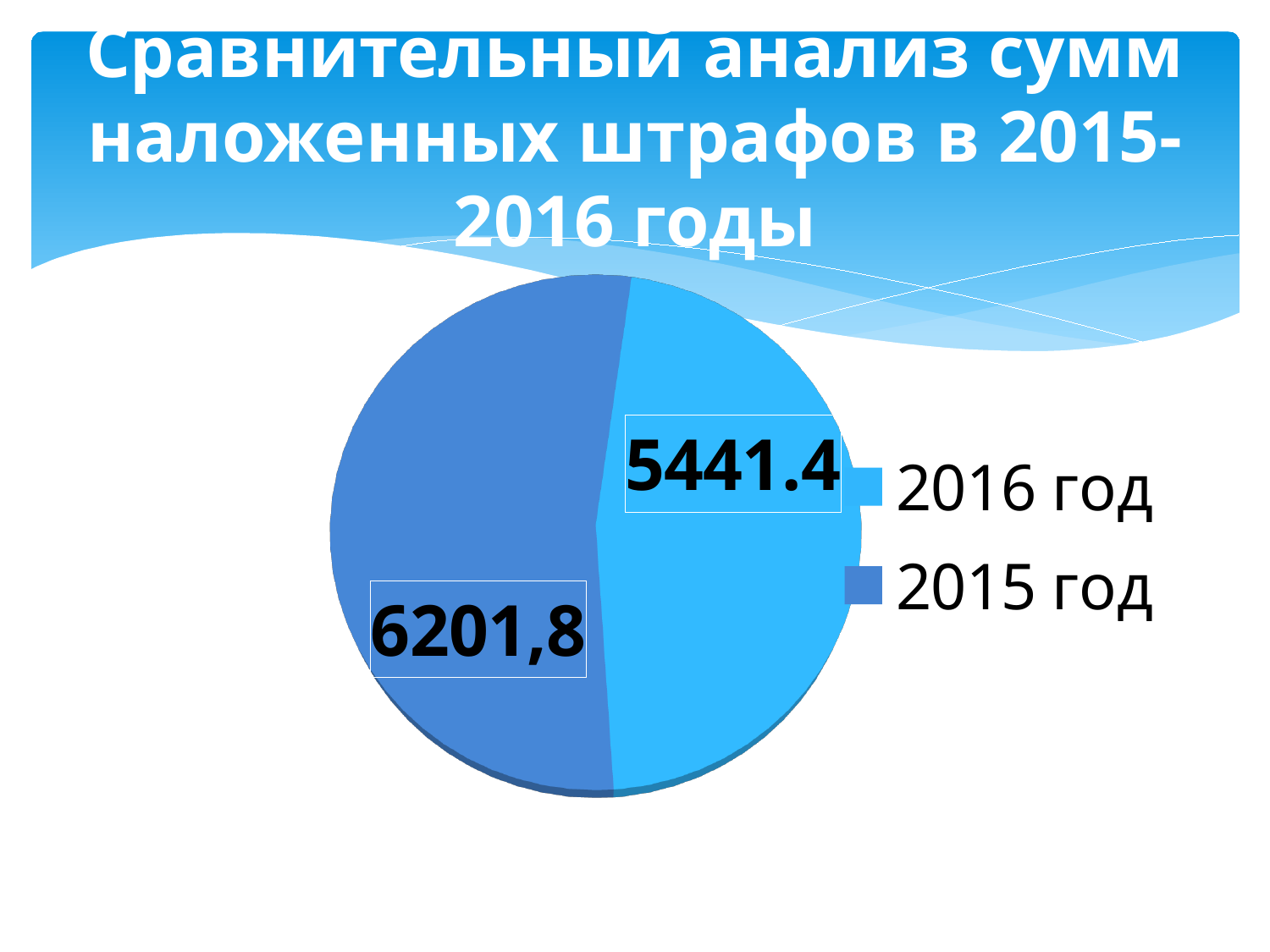
What is the title of the slide? Сравнительный анализ сумм наложенных штрафов в 2015-2016 годы Which year has the smaller slice in the pie chart? 2016 год How many entries does the legend list? 2 How many slices does the pie chart have? 2 Which year has the larger slice in the pie chart? 2015 год What is the value shown for 2015 год in the pie chart? 6201,8 Is the value for 2015 год larger or smaller than the value for 2016 год? larger What is the difference between the values for 2015 год and 2016 год? 760.4 What is the value shown for 2016 год in the pie chart? 5441.4 What kind of chart is shown on the slide? pie chart What is the total of the two values shown in the pie chart? 11643.2